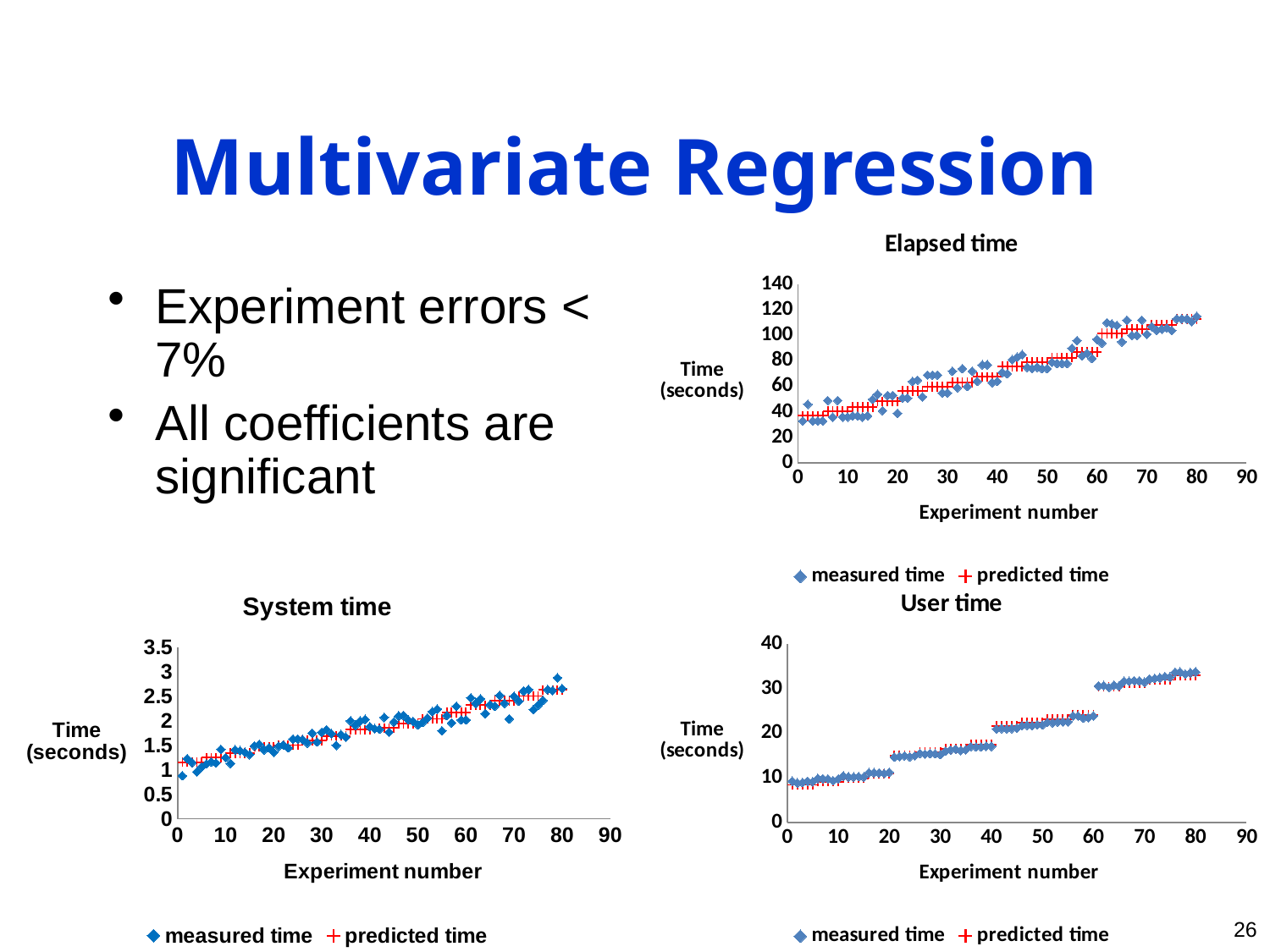
In the Elapsed time chart, is the measured time at experiment number 80 greater or less than 100? greater What are the two series named in the legend of the User time chart? measured time and predicted time What is the x-axis label of the Elapsed time chart? Experiment number What kind of chart is the Elapsed time chart? scatter chart In the User time chart, do the measured time values rise or fall as the experiment number increases? rise In the System time chart, is the measured time at experiment number 80 greater or less than 2? greater In the System time chart, do the values rise or fall as the experiment number increases? rise How many series does the legend of the System time chart list? 2 In the Elapsed time chart, do the predicted time values rise or fall along the x axis? rise In the User time chart, is the measured time at experiment number 80 greater or less than 30? greater